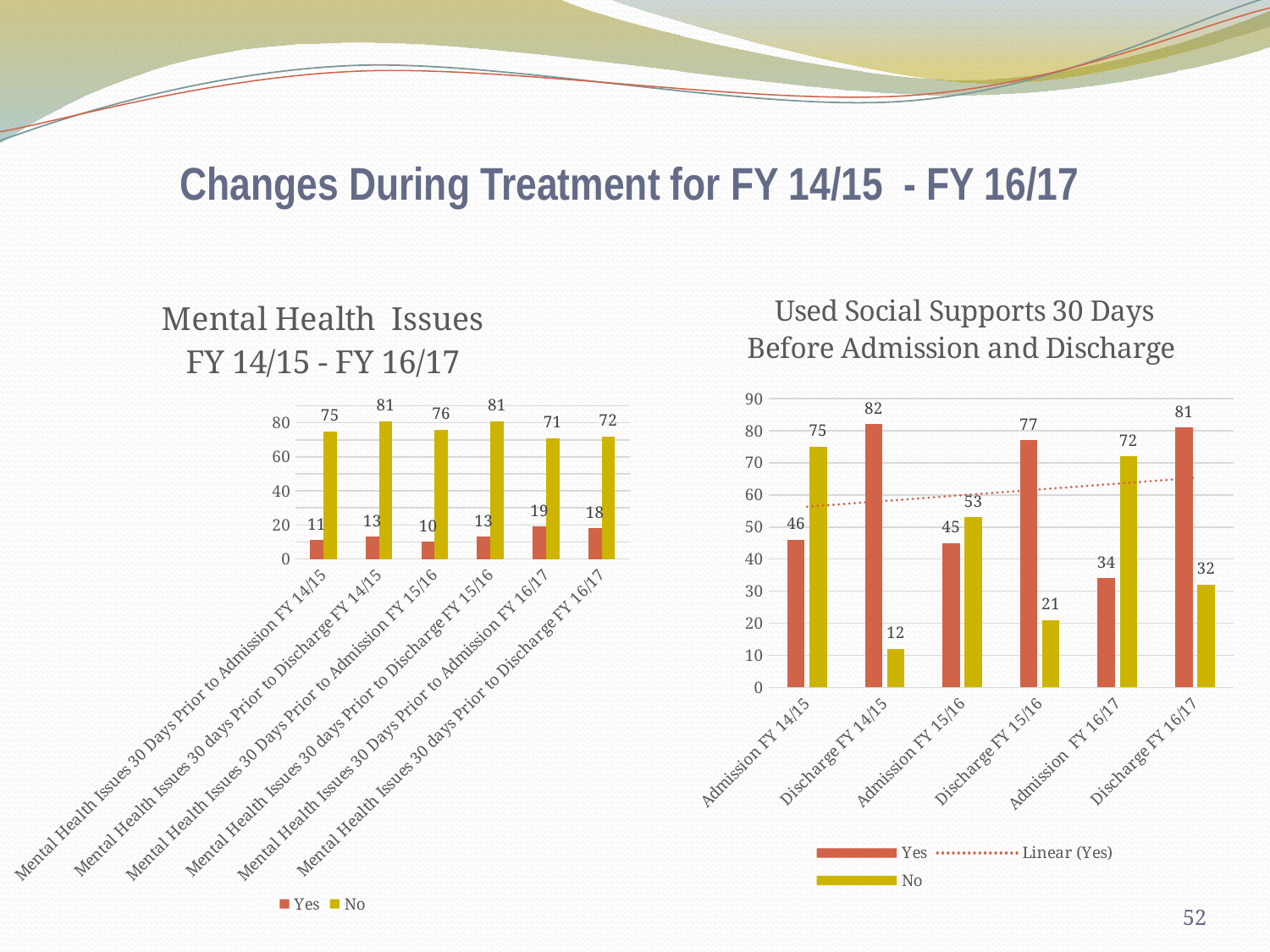
In the 'Mental Health Issues FY 14/15 - FY 16/17' chart, which category has the lowest 'Yes' value? Mental Health Issues 30 Days Prior to Admission FY 15/16 In the 'Used Social Supports 30 Days Before Admission and Discharge' chart, which category has the lowest 'No' value? Discharge FY 14/15 In the 'Used Social Supports 30 Days Before Admission and Discharge' chart, what is the 'Yes' value for Discharge FY 14/15? 82 In the 'Mental Health Issues FY 14/15 - FY 16/17' chart, what is the 'Yes' value for Mental Health Issues 30 Days Prior to Admission FY 16/17? 19 In the 'Used Social Supports 30 Days Before Admission and Discharge' chart, which is larger for Admission FY 15/16: the 'Yes' value or the 'No' value? No How many series does the legend of the 'Used Social Supports 30 Days Before Admission and Discharge' chart list? 3 In the 'Used Social Supports 30 Days Before Admission and Discharge' chart, what is the difference between the 'Yes' values for Discharge FY 16/17 and Admission FY 16/17? 47 In the 'Used Social Supports 30 Days Before Admission and Discharge' chart, what is the 'No' value for Admission FY 16/17? 72 In the 'Mental Health Issues FY 14/15 - FY 16/17' chart, what is the difference between the 'No' values for Prior to Discharge FY 14/15 and Prior to Admission FY 14/15? 6 How many categories are shown on the x axis of the 'Mental Health Issues FY 14/15 - FY 16/17' chart? 6 What type of chart is the 'Mental Health Issues FY 14/15 - FY 16/17' chart? Bar chart In the 'Mental Health Issues FY 14/15 - FY 16/17' chart, what is the 'No' value for Mental Health Issues 30 Days Prior to Admission FY 15/16? 76